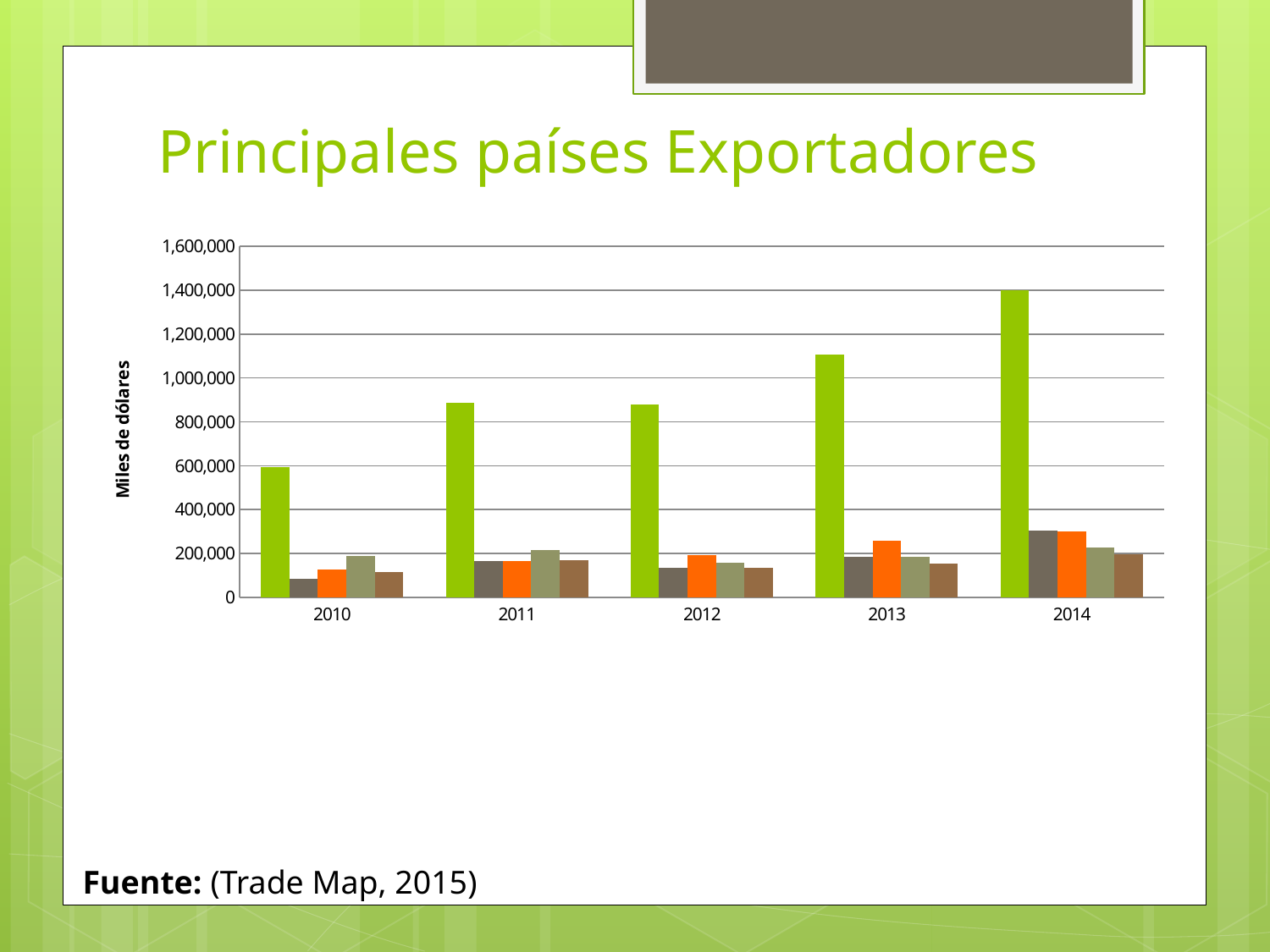
In which year is the tallest green bar in the chart? 2014 Is the green bar for 2010 greater or less than 800,000? less How many years are shown along the x axis of the chart? 5 Is the green bar for 2014 greater or less than 1,200,000? greater What kind of chart is shown on the slide? bar chart How many bars are plotted for each year in the chart? 5 Which is larger, the green bar for 2013 or the green bar for 2014? 2014 Is the orange bar for 2014 greater or less than 400,000? less What is the highest value shown on the vertical axis of the chart? 1,600,000 What is the label on the vertical axis of the chart? Miles de dólares In which year is the green bar the lowest? 2010